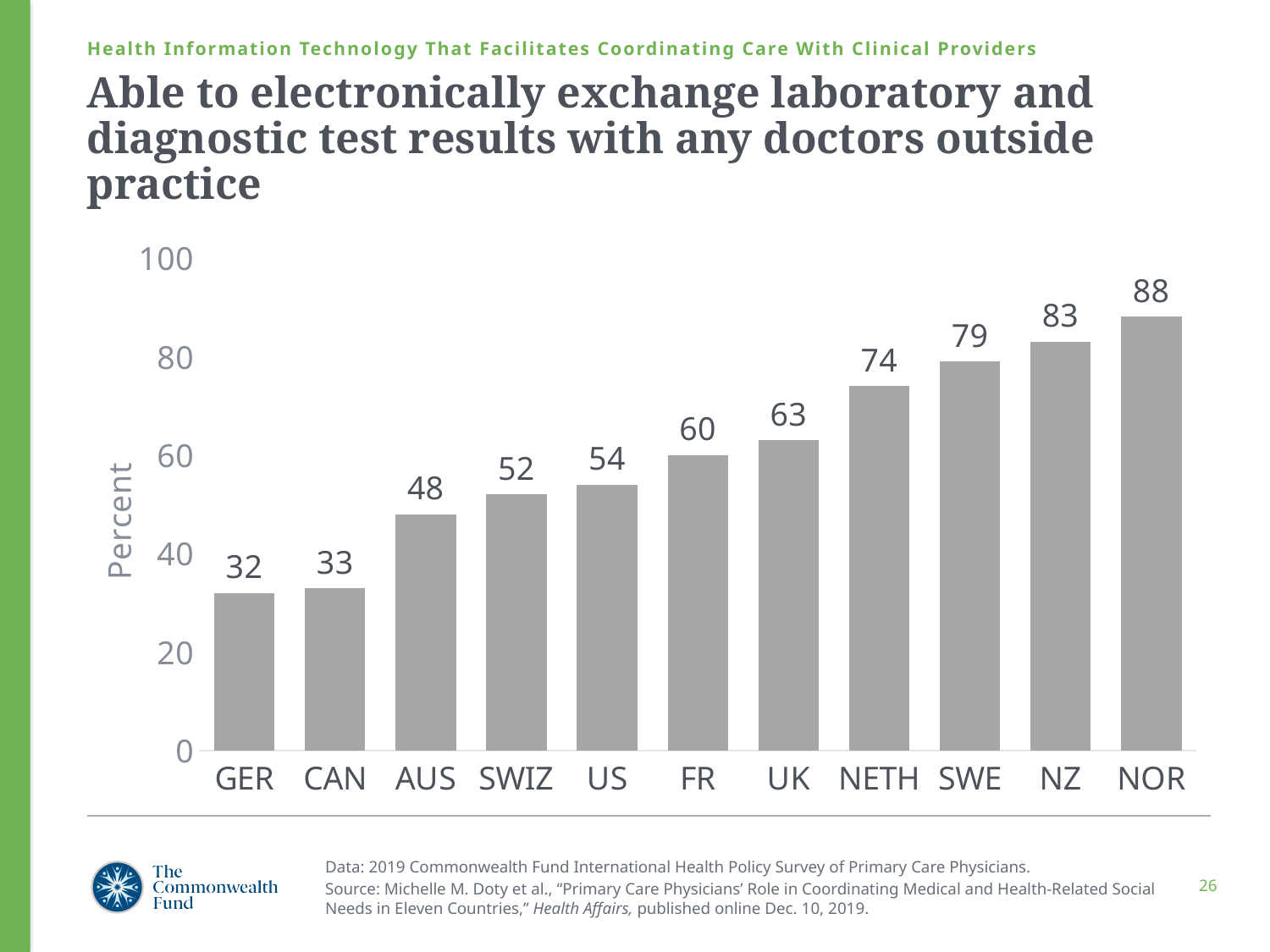
What kind of chart is shown on the slide? Bar chart Which is larger, the value for SWE or the value for AUS? SWE What is the value for GER? 32 What is the difference between the values for NOR and GER? 56 What is the difference between the values for UK and FR? 3 Which country has the lowest value? GER How many countries are shown on the chart? 11 Is the value for NZ greater or less than 80? greater What is the value for the US? 54 What is the label on the vertical axis? Percent Which country has the highest value? NOR What is the value for NETH? 74